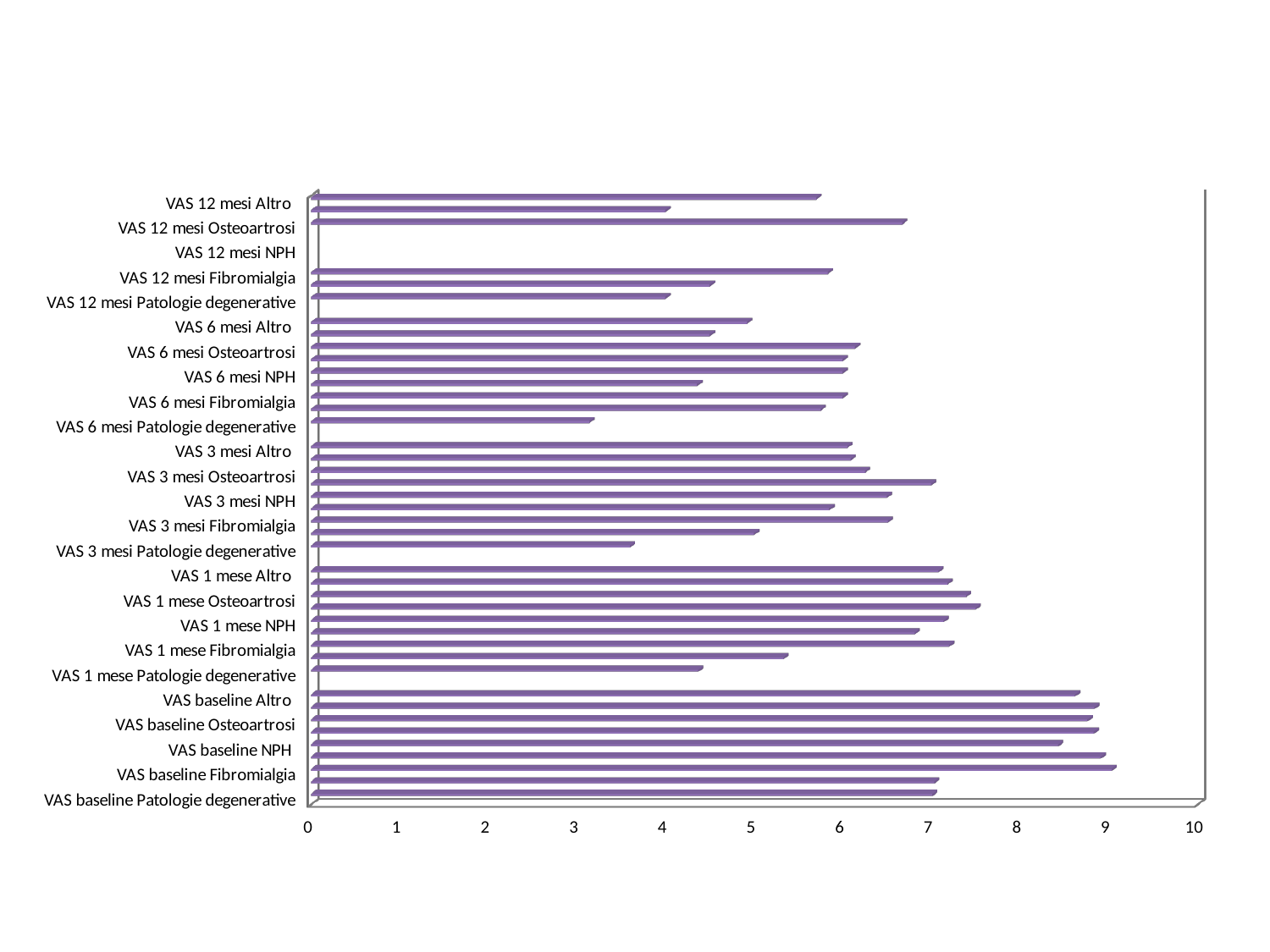
Is the value for VAS 3 mesi Osteoartrosi greater or less than 6? greater Is the value for VAS 1 mese Altro greater or less than 6? greater Is the value for VAS baseline NPH greater or less than 8? greater What kind of chart is shown on the slide? bar chart What is the highest value shown on the horizontal axis? 10